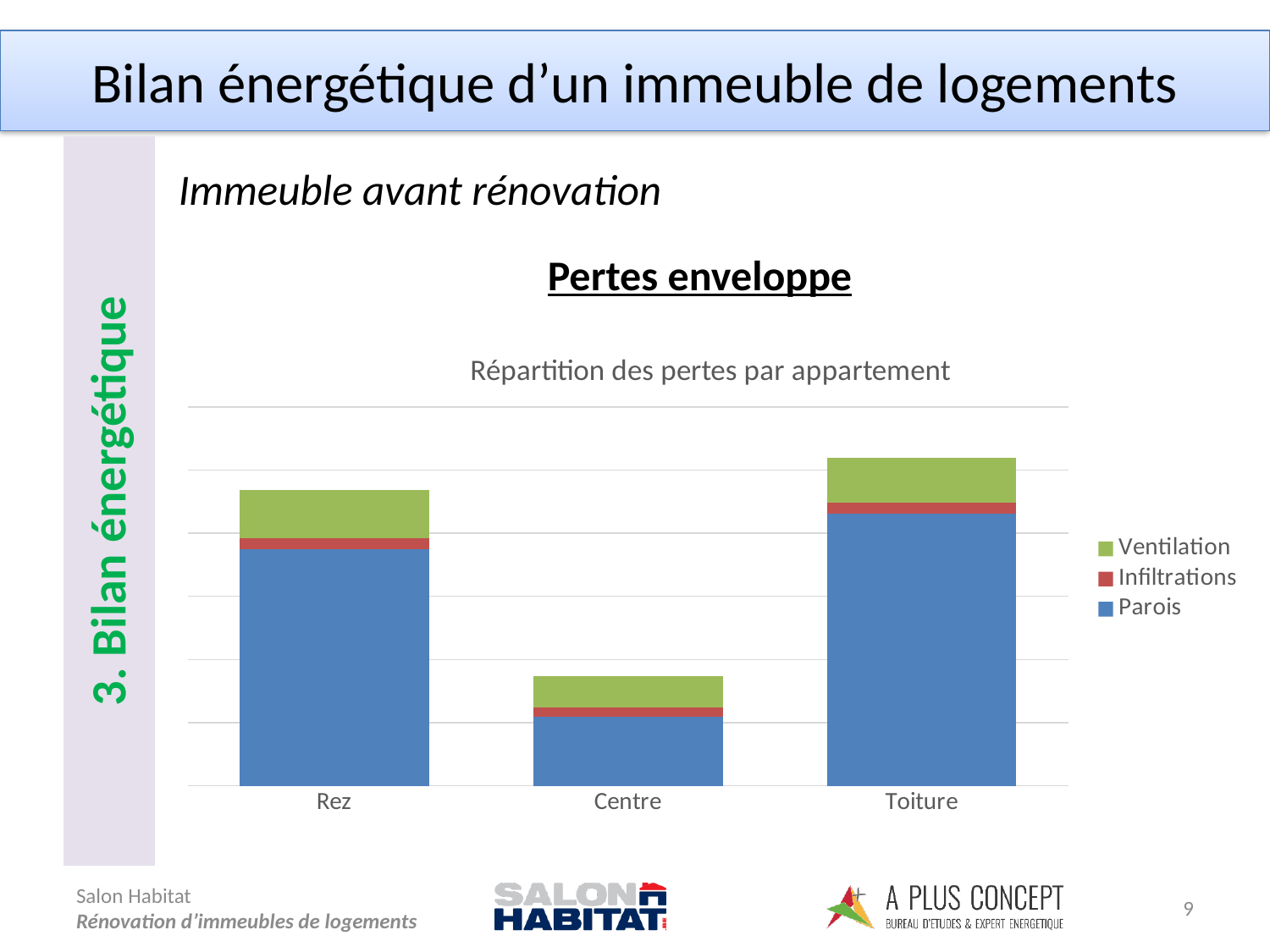
What kind of chart is shown on the slide? Stacked bar chart How many series does the chart legend list? 3 Which series makes up the largest part of the Toiture bar? Parois How many categories are shown on the x axis of the chart? 3 What is the title of the chart? Répartition des pertes par appartement Which has a larger total bar, Toiture or Rez? Toiture Which series makes up the smallest part of the Rez bar? Infiltrations Which category has the highest total losses in the chart? Toiture Which series are listed in the chart legend? Ventilation, Infiltrations, Parois Does the total bar height rise or fall from Rez to Centre? Fall Which category has the lowest total losses in the chart? Centre